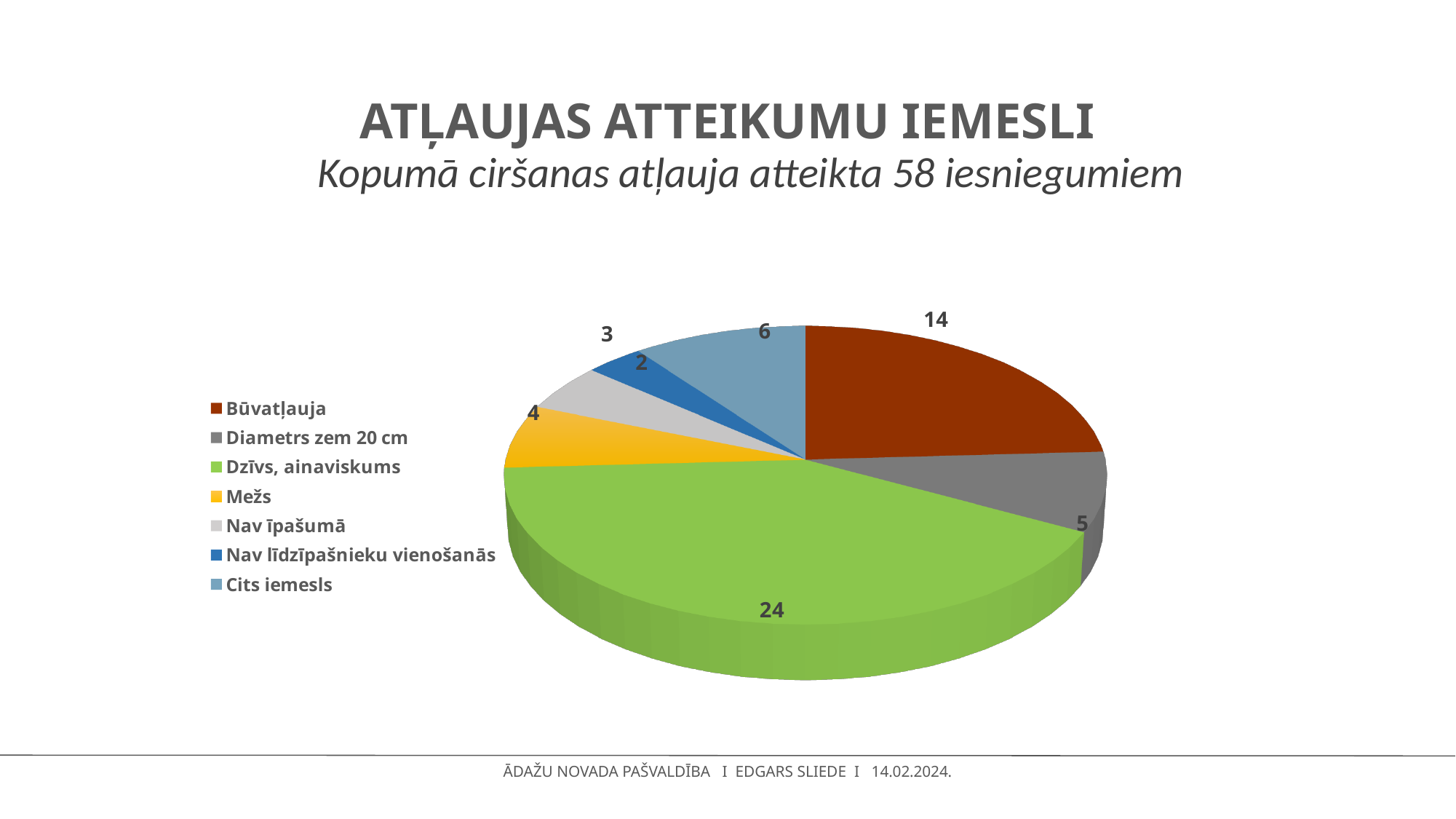
What is the value for Nav līdzīpašnieku vienošanās? 2 What is the value for Cits iemesls? 6 What kind of chart is shown on the slide? Pie chart Which is larger, the value for Mežs or the value for Diametrs zem 20 cm? Diametrs zem 20 cm What is the title of the chart slide? ATĻAUJAS ATTEIKUMU IEMESLI What is the value for Būvatļauja? 14 What share of the pie does Dzīvs, ainaviskums represent? 41.4% What is the value for Dzīvs, ainaviskums? 24 How many categories does the pie chart have? 7 Which category has the smallest slice? Nav līdzīpašnieku vienošanās What is the difference between the values for Dzīvs, ainaviskums and Būvatļauja? 10 Which category has the largest slice? Dzīvs, ainaviskums